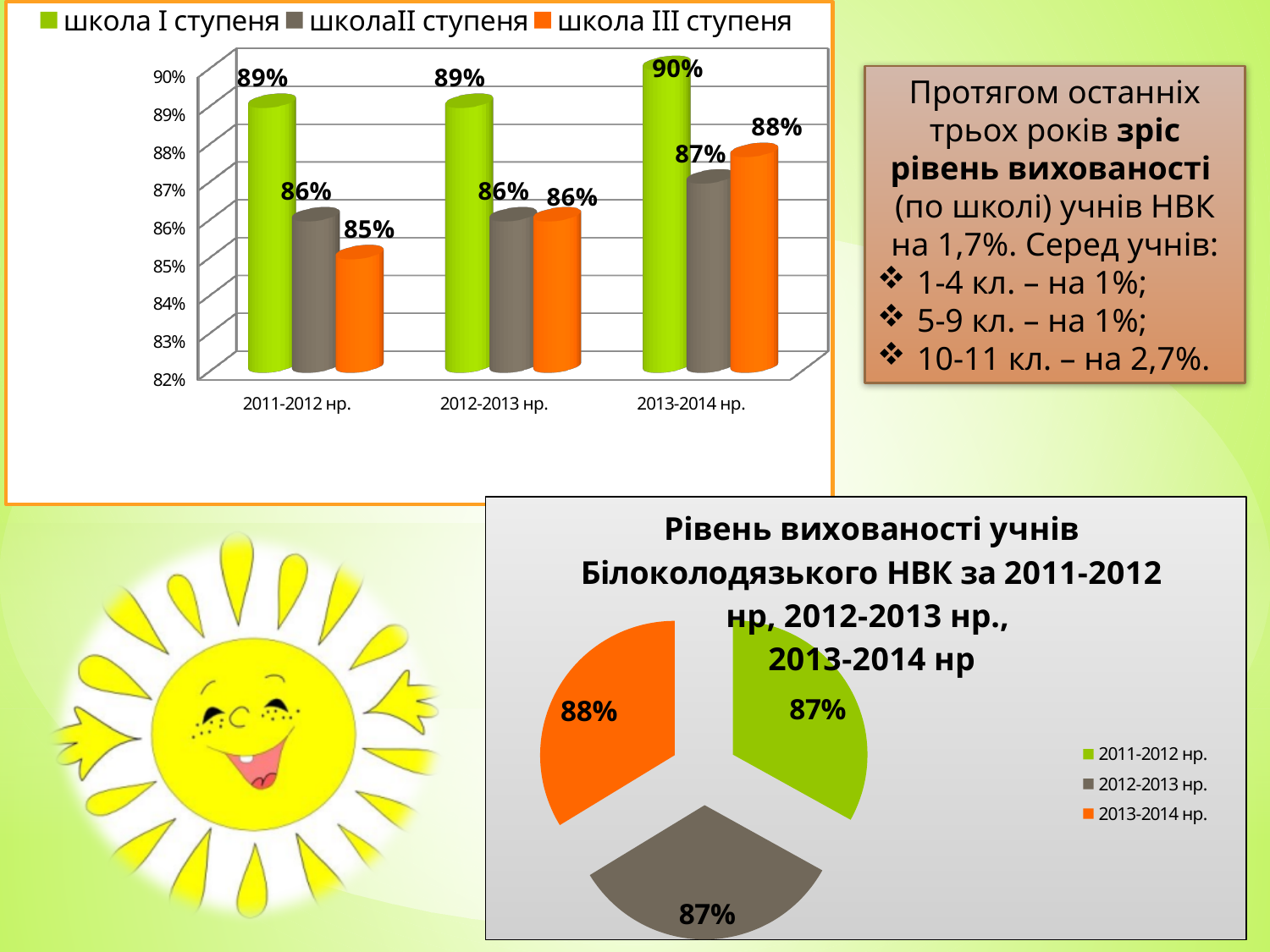
In the bar chart at the top left of the slide, what is the value for школа III ступеня in 2011-2012 нр.? 85% In the bar chart at the top left of the slide, which is larger in 2013-2014 нр.: школаII ступеня or школа III ступеня? школа III ступеня In the bar chart at the top left of the slide, does the value for школа I ступеня rise or fall from 2012-2013 нр. to 2013-2014 нр.? rise What kind of chart is the chart at the top left of the slide? bar chart In the pie chart titled 'Рівень вихованості учнів Білоколодязького НВК', how many slices are there? 3 In the bar chart at the top left of the slide, what is the value for школаII ступеня in 2012-2013 нр.? 86% In the bar chart at the top left of the slide, what is the value for школа I ступеня in 2013-2014 нр.? 90% In the bar chart at the top left of the slide, how many series does the legend list? 3 In the bar chart at the top left of the slide, which year has the highest value for школа III ступеня? 2013-2014 нр. In the bar chart at the top left of the slide, which series has the lowest value in 2011-2012 нр.? школа III ступеня In the pie chart titled 'Рівень вихованості учнів Білоколодязького НВК', what is the value shown for 2013-2014 нр.? 88% In the bar chart at the top left of the slide, what is the difference between школа I ступеня and школа III ступеня in 2011-2012 нр.? 4%